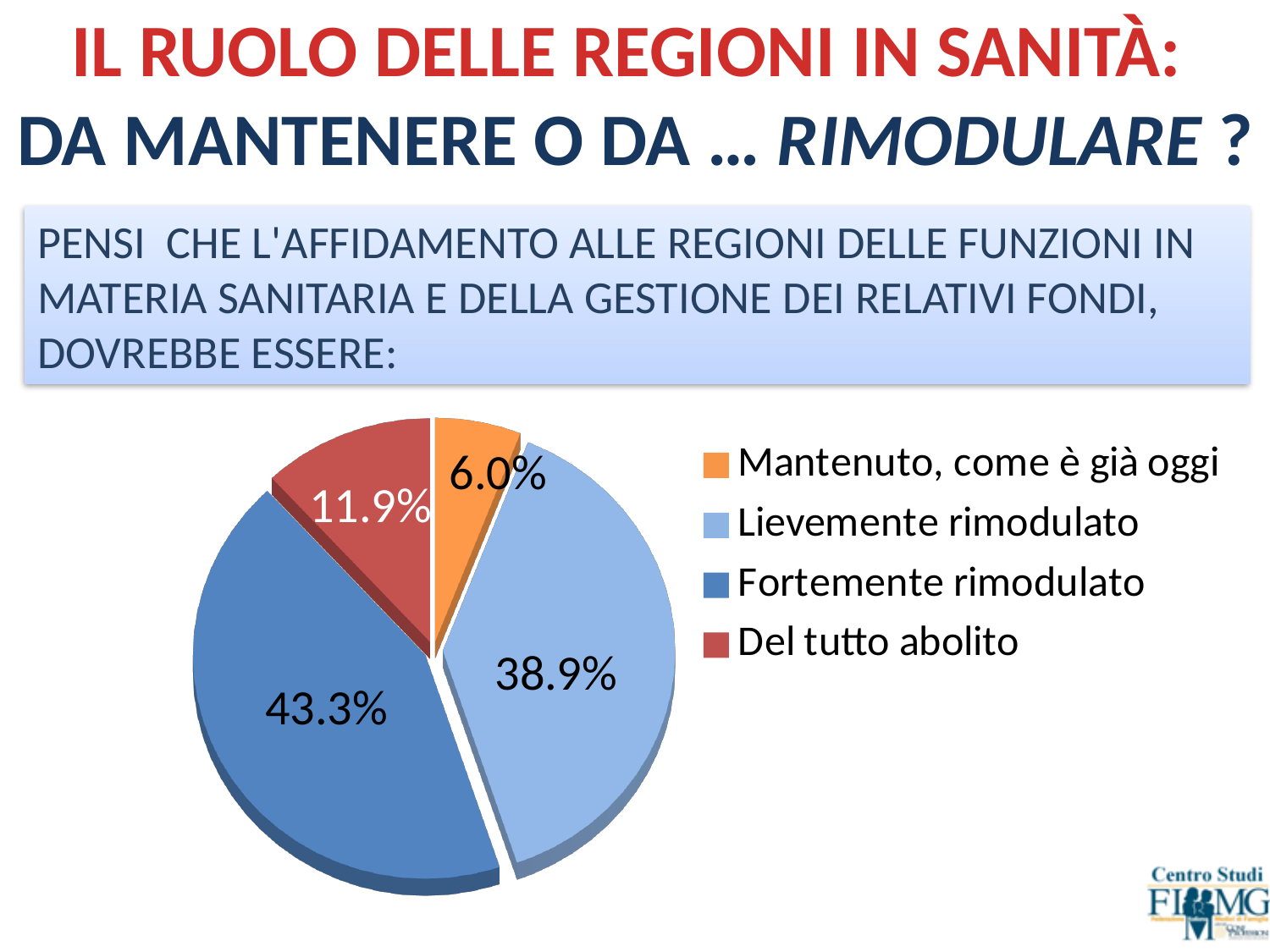
What is the difference between the shares for 'Fortemente rimodulato' and 'Lievemente rimodulato'? 4.4% What share of the pie is 'Del tutto abolito'? 11.9% Which is larger: the share for 'Del tutto abolito' or the share for 'Mantenuto, come è già oggi'? Del tutto abolito What share of the pie is 'Mantenuto, come è già oggi'? 6.0% What share of the pie is 'Fortemente rimodulato'? 43.3% Which category has the smallest slice of the pie? Mantenuto, come è già oggi What is the difference between the shares for 'Del tutto abolito' and 'Mantenuto, come è già oggi'? 5.9% How many categories does the pie chart have? 4 What kind of chart is shown on the slide? pie chart What colour is the slice for 'Del tutto abolito'? red Which category has the largest slice of the pie? Fortemente rimodulato